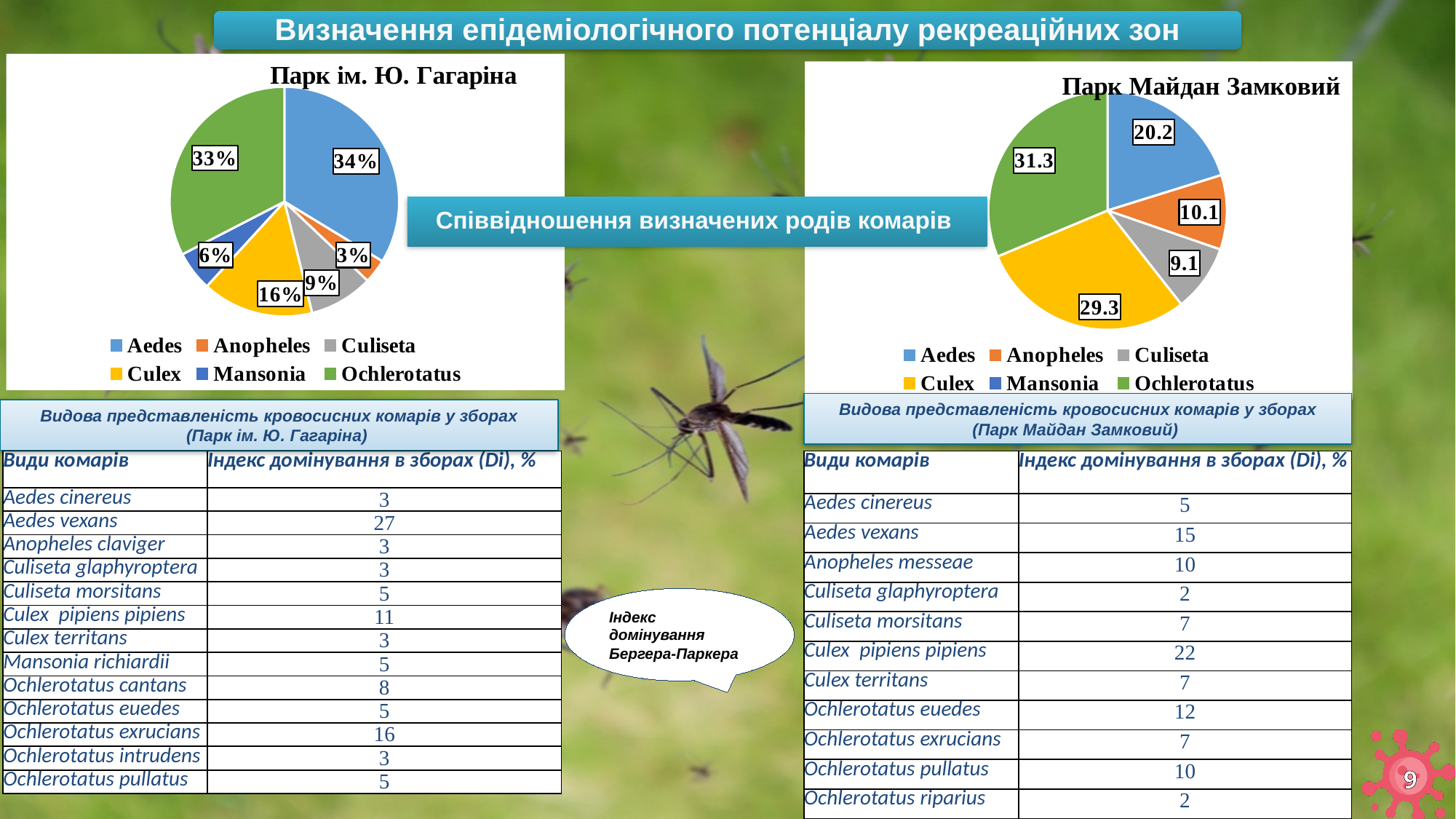
In the pie chart titled "Парк Майдан Замковий", what is the value for Anopheles? 10.1 In the pie chart titled "Парк Майдан Замковий", which is larger, Aedes or Anopheles? Aedes In the pie chart titled "Парк Майдан Замковий", what is the difference between the Aedes and Culiseta values? 11.1 In the pie chart titled "Парк ім. Ю. Гагаріна", what is the difference between the Culex and Mansonia shares? 10% How many entries does the legend of the pie chart titled "Парк ім. Ю. Гагаріна" list? 6 In the pie chart titled "Парк ім. Ю. Гагаріна", what share does Culex have? 16% In the pie chart titled "Парк ім. Ю. Гагаріна", which is larger, Culiseta or Mansonia? Culiseta In the pie chart titled "Парк ім. Ю. Гагаріна", what share does Aedes have? 34% In the pie chart titled "Парк Майдан Замковий", which genus has the largest slice? Ochlerotatus In the pie chart titled "Парк Майдан Замковий", what is the value for Culex? 29.3 In the pie chart titled "Парк ім. Ю. Гагаріна", which genus has the smallest slice? Anopheles What type of chart is used for "Парк Майдан Замковий"? Pie chart